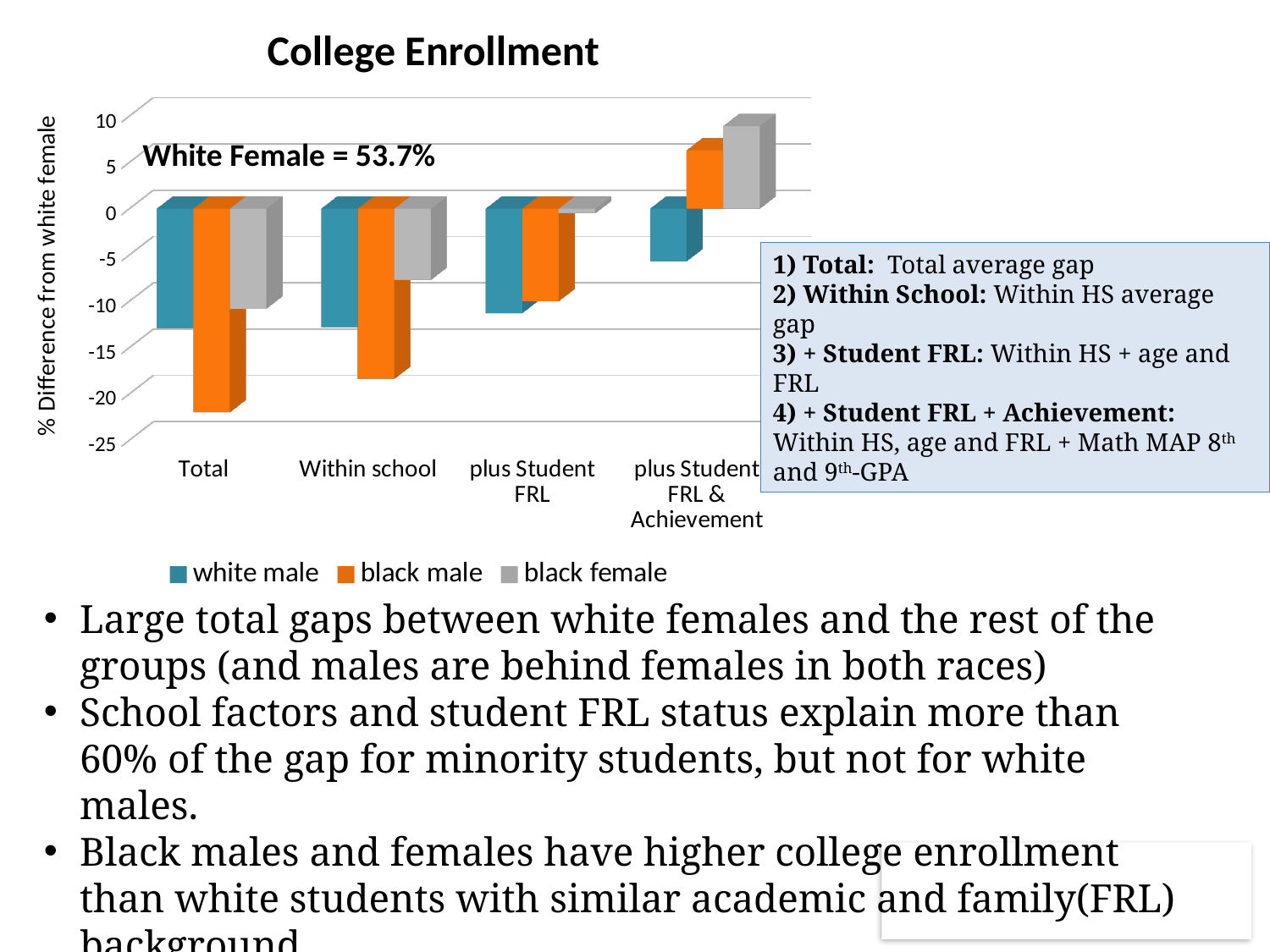
Do the values for black male rise or fall moving from Total to plus Student FRL & Achievement along the x axis? rise Is the value for black male in the Total category greater or less than -15? less What value for white female is stated in the annotation on the chart? 53.7% How many series does the legend list? 3 In the Within school category, which is larger: the value for black female or the value for black male? black female In the plus Student FRL & Achievement category, which series has the highest value? black female What is the title of the chart? College Enrollment Is the value for black female in the plus Student FRL & Achievement category greater or less than 5? greater Is the value for white male in the plus Student FRL & Achievement category greater or less than 0? less In the Total category, which series has the lowest value? black male How many categories are shown along the x axis? 4 What kind of chart is shown on the slide? bar chart